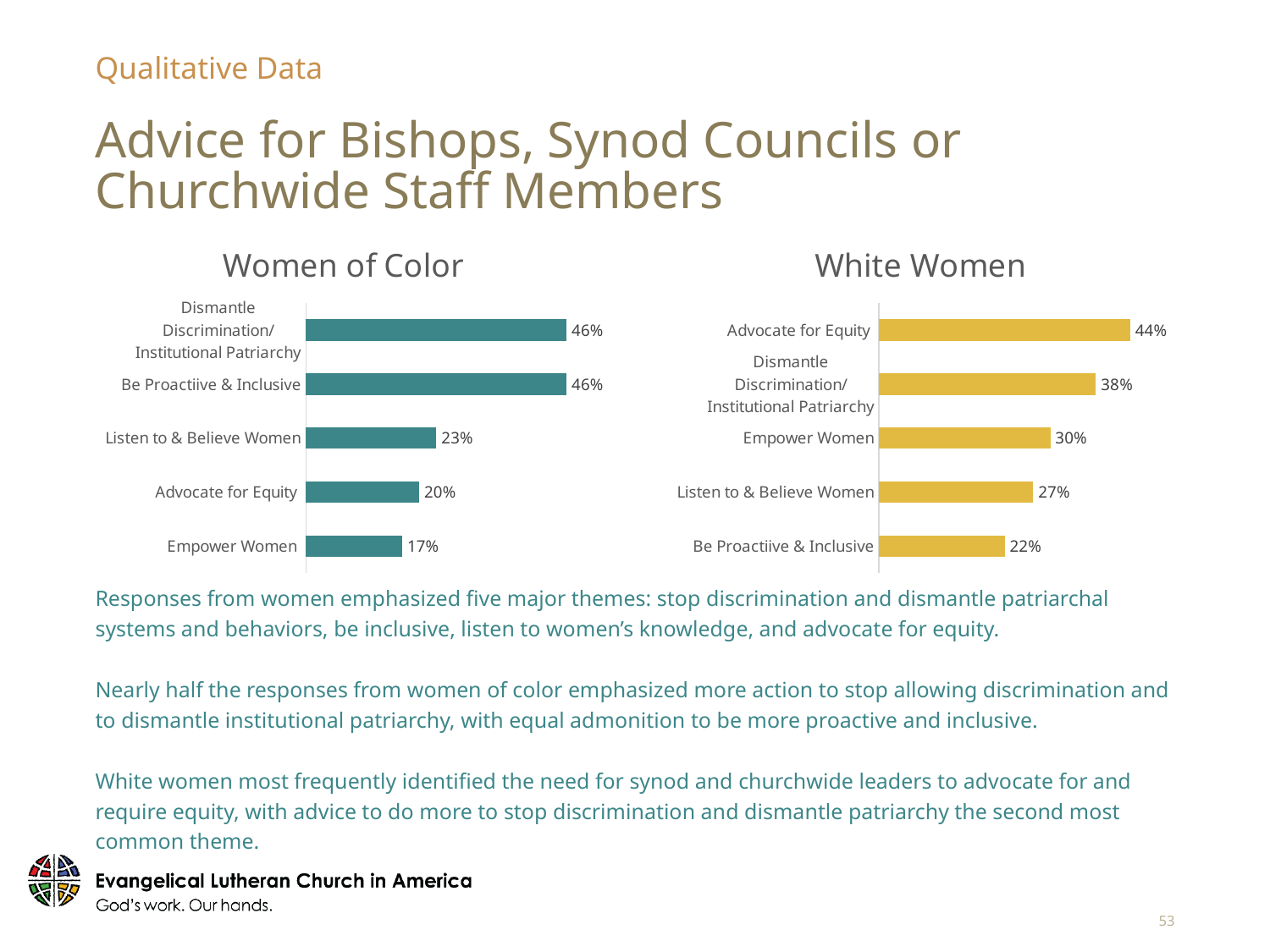
Which is larger: Advocate for Equity in the Women of Color chart or Advocate for Equity in the White Women chart? White Women What is the title of the chart on the left side of the slide? Women of Color How many categories does the Women of Color chart show? 5 In the White Women chart, which category has the lowest value? Be Proactiive & Inclusive In the White Women chart, what is the value for Empower Women? 30% In the Women of Color chart, what is the value for Listen to & Believe Women? 23% In the Women of Color chart, what is the value for Advocate for Equity? 20% What kind of chart is the White Women chart? Bar chart In the Women of Color chart, what is the difference between Be Proactiive & Inclusive and Empower Women? 29% In the White Women chart, what is the difference between Advocate for Equity and Dismantle Discrimination/Institutional Patriarchy? 6% In the White Women chart, which category has the highest value? Advocate for Equity In the Women of Color chart, which category has the lowest value? Empower Women